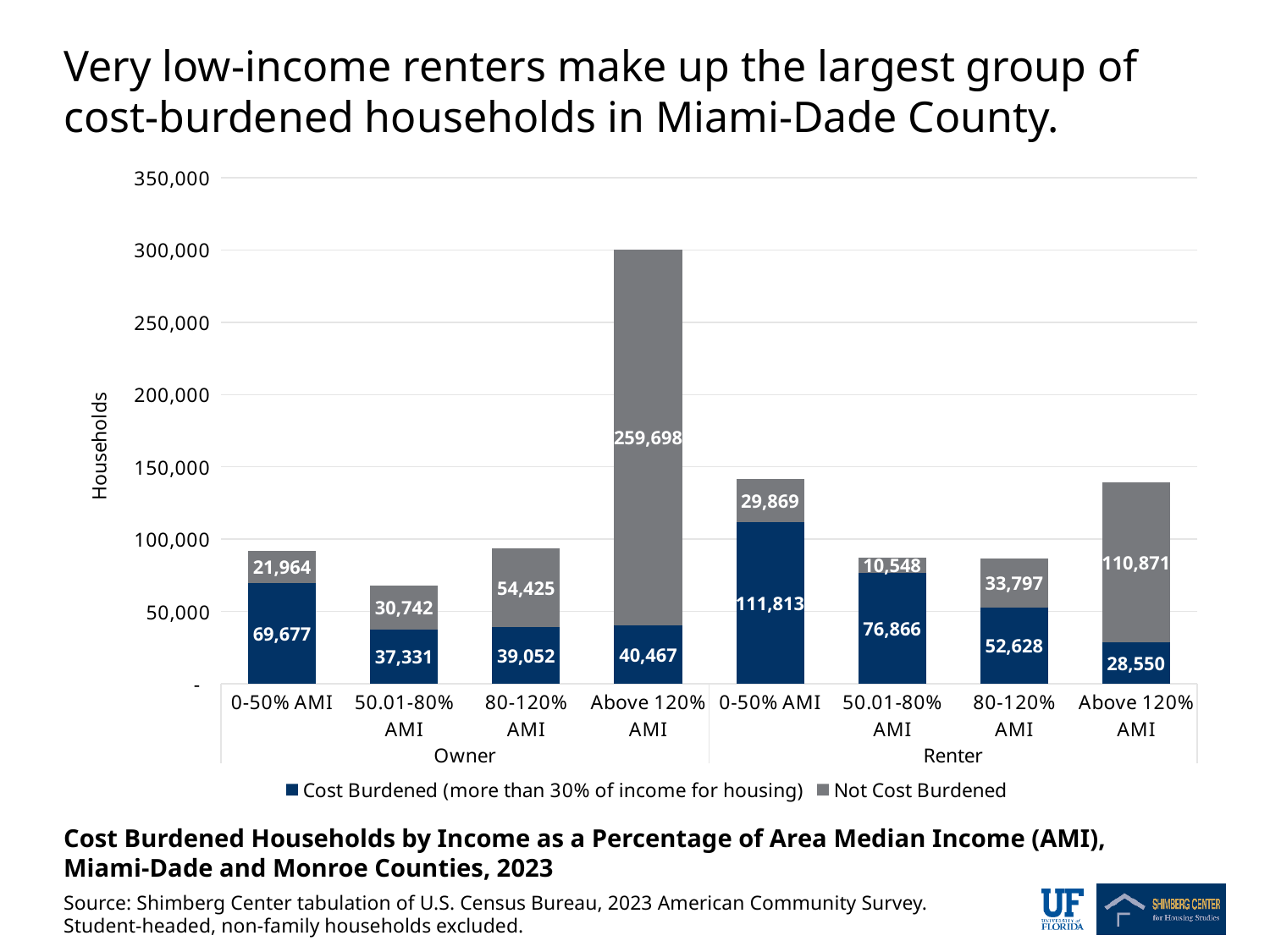
Which category has the lowest number of cost-burdened households? Renter, Above 120% AMI What is the number of cost-burdened owner households in the 80-120% AMI category? 39,052 How many series does the legend list? 2 What kind of chart is shown on the slide? Stacked bar chart What is the number of cost-burdened renter households in the 0-50% AMI category? 111,813 What is the number of not-cost-burdened owner households in the Above 120% AMI category? 259,698 Which category has the highest number of cost-burdened households? Renter, 0-50% AMI What is the total number of owner households in the 0-50% AMI category (cost burdened plus not cost burdened)? 91,641 What is the difference between cost-burdened renter households and cost-burdened owner households in the 0-50% AMI category? 42,136 Is the total height of the Owner Above 120% AMI bar greater or less than 250,000? greater Which is larger: the number of not-cost-burdened renter households in the 50.01-80% AMI category or in the 80-120% AMI category? 80-120% AMI How many income categories (bars) are plotted across the Owner and Renter groups combined? 8